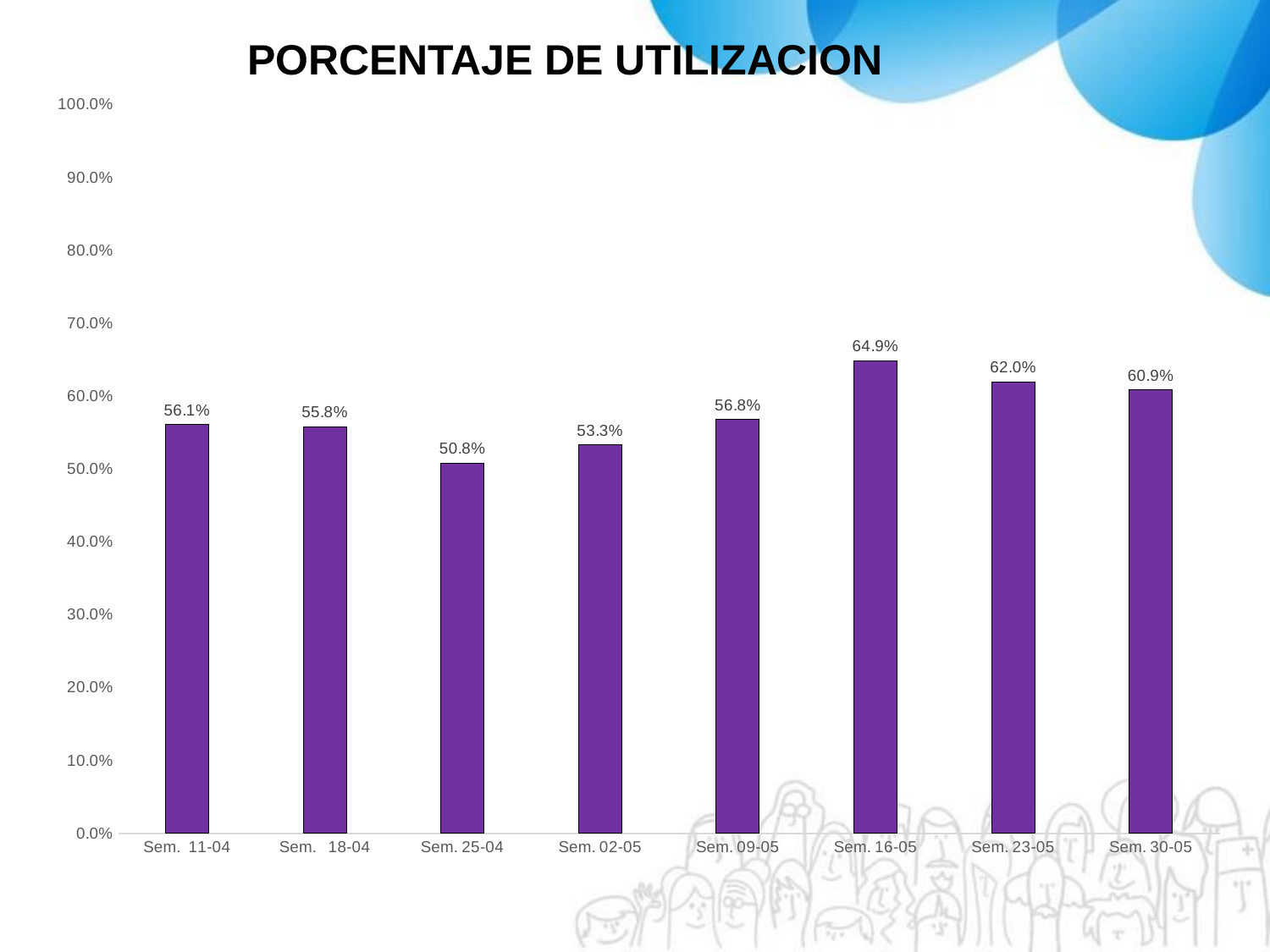
Is the value for Sem. 09-05 greater or less than 50.0%? greater What is the value for Sem. 16-05? 64.9% How many weeks are shown on the chart? 8 Which is larger, the value for Sem. 23-05 or the value for Sem. 30-05? Sem. 23-05 What is the difference between the values for Sem. 16-05 and Sem. 25-04? 14.1% What is the value for Sem. 11-04? 56.1% Which week has the lowest utilization percentage? Sem. 25-04 Which week has the highest utilization percentage? Sem. 16-05 Do the values rise or fall from Sem. 02-05 to Sem. 16-05? rise What kind of chart is shown on the slide? bar chart What is the title of the chart? PORCENTAJE DE UTILIZACION What is the value for Sem. 25-04? 50.8%